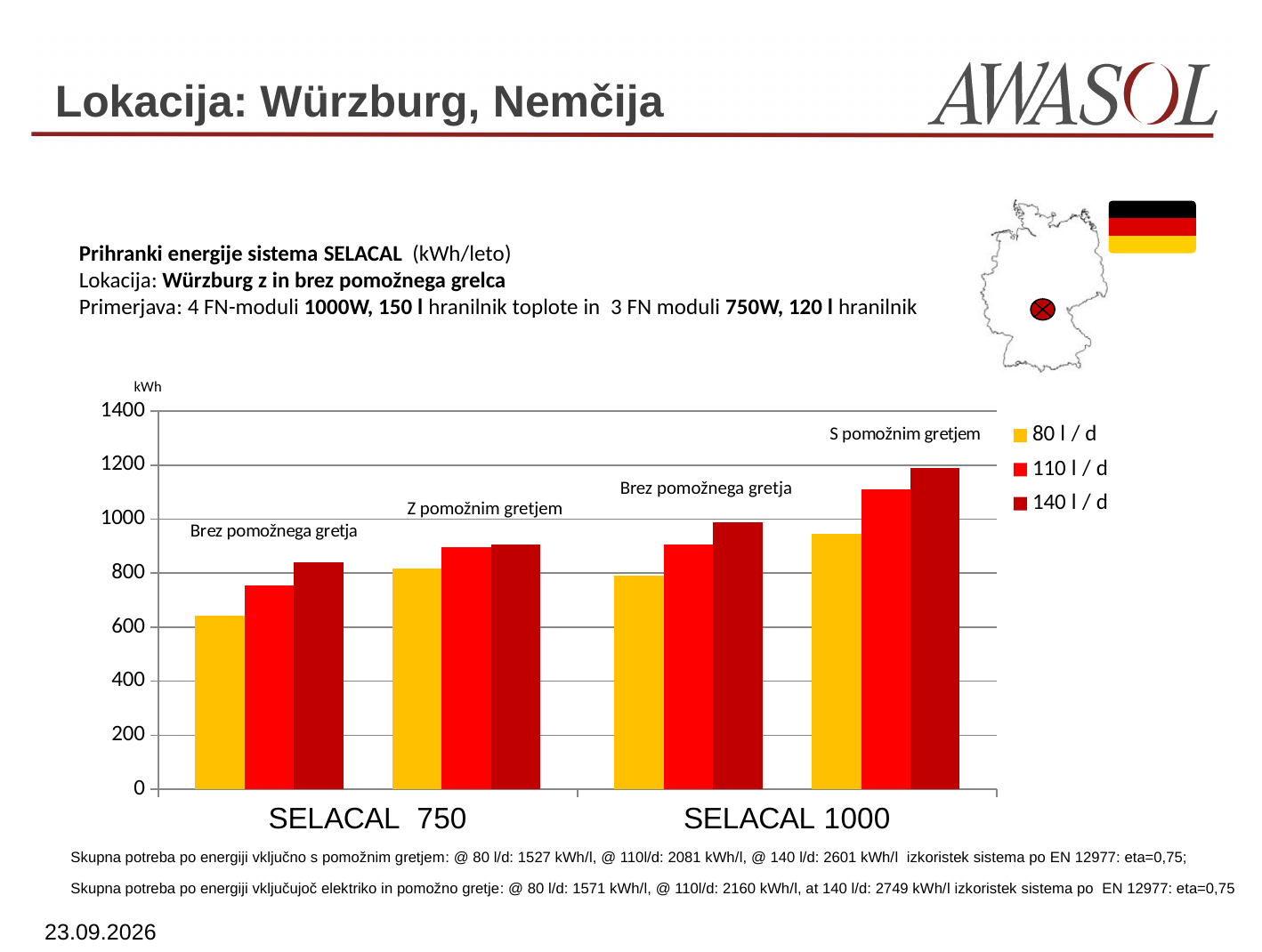
Is the value for 140 l / d in the SELACAL 750 'Brez pomožnega gretja' group greater or less than 1000? less What kind of chart is shown on the slide? bar chart What unit is shown on the vertical axis? kWh Is the value for 110 l / d in the SELACAL 1000 'S pomožnim gretjem' group greater or less than 1000? greater Is the value for 80 l / d in the SELACAL 750 'Brez pomožnega gretja' group greater or less than 800? less Which bar in the chart is the highest? 140 l / d, SELACAL 1000 S pomožnim gretjem Within the SELACAL 1000 'S pomožnim gretjem' group, which is larger: the 80 l / d bar or the 140 l / d bar? 140 l / d Which bar in the chart is the lowest? 80 l / d, SELACAL 750 Brez pomožnega gretja How many series does the legend list? 3 Within each group, do the values rise or fall from 80 l / d to 140 l / d? rise Which series is shown in yellow in the legend? 80 l / d